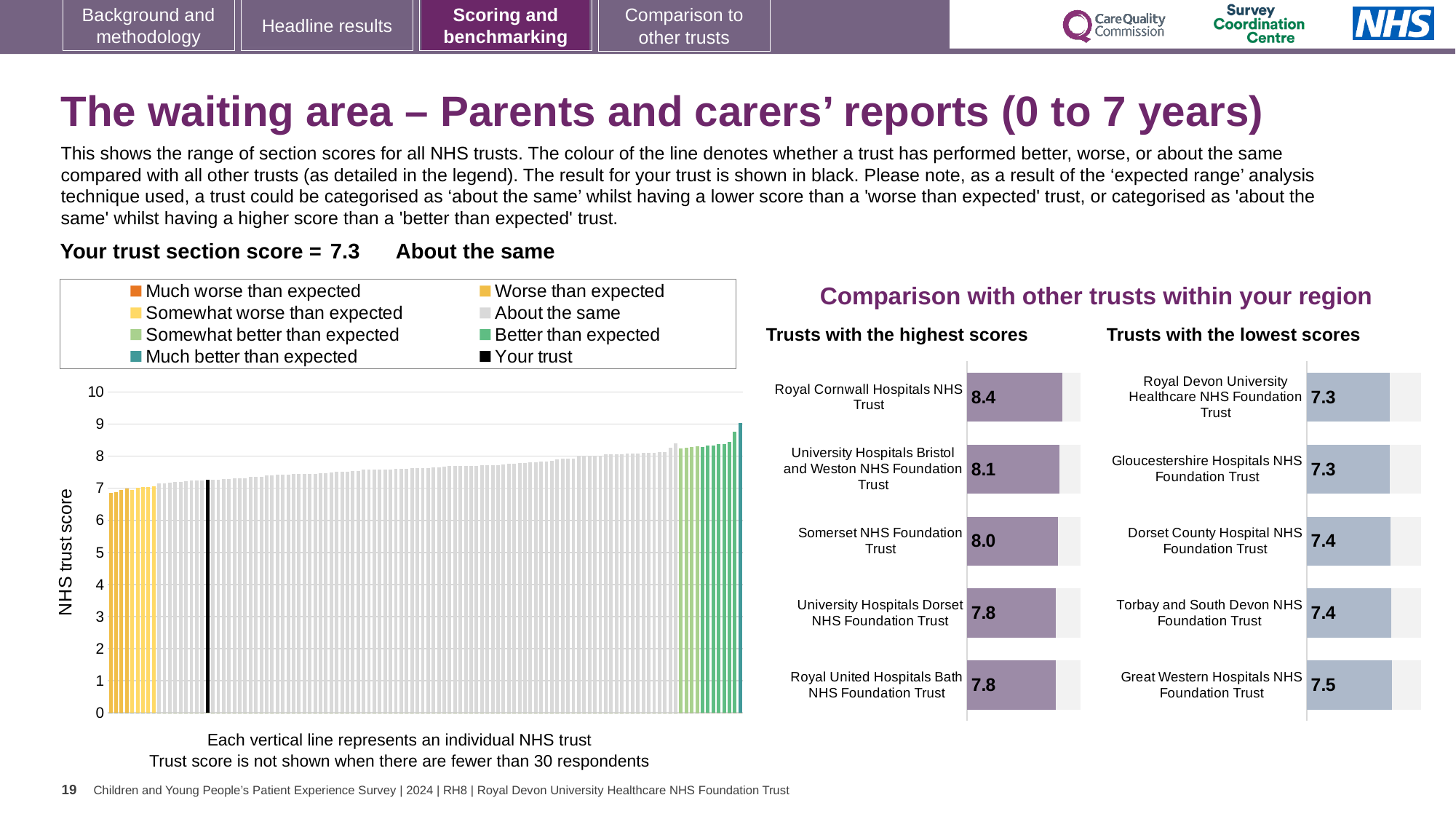
Which has a higher score: Somerset NHS Foundation Trust in the highest scores chart or Gloucestershire Hospitals NHS Foundation Trust in the lowest scores chart? Somerset NHS Foundation Trust How many entries does the legend of the main NHS trust score chart list? 8 How many trusts are shown in the 'Trusts with the highest scores' chart? 5 In the 'Trusts with the lowest scores' chart, what is the score for Dorset County Hospital NHS Foundation Trust? 7.4 In the 'Trusts with the highest scores' chart, what is the score for Somerset NHS Foundation Trust? 8.0 In the main NHS trust score chart, do the values rise or fall from left to right? Rise In the 'Trusts with the highest scores' chart, which trust has the highest score? Royal Cornwall Hospitals NHS Trust In the 'Trusts with the lowest scores' chart, what is the score for Great Western Hospitals NHS Foundation Trust? 7.5 In the 'Trusts with the highest scores' chart, what is the difference between the scores of Royal Cornwall Hospitals NHS Trust and Royal United Hospitals Bath NHS Foundation Trust? 0.6 In the 'Trusts with the highest scores' chart, what is the score for Royal Cornwall Hospitals NHS Trust? 8.4 What kind of chart is the main chart showing NHS trust scores on the left of the slide? Bar chart In the 'Trusts with the lowest scores' chart, which trust has the lowest score listed first? Royal Devon University Healthcare NHS Foundation Trust